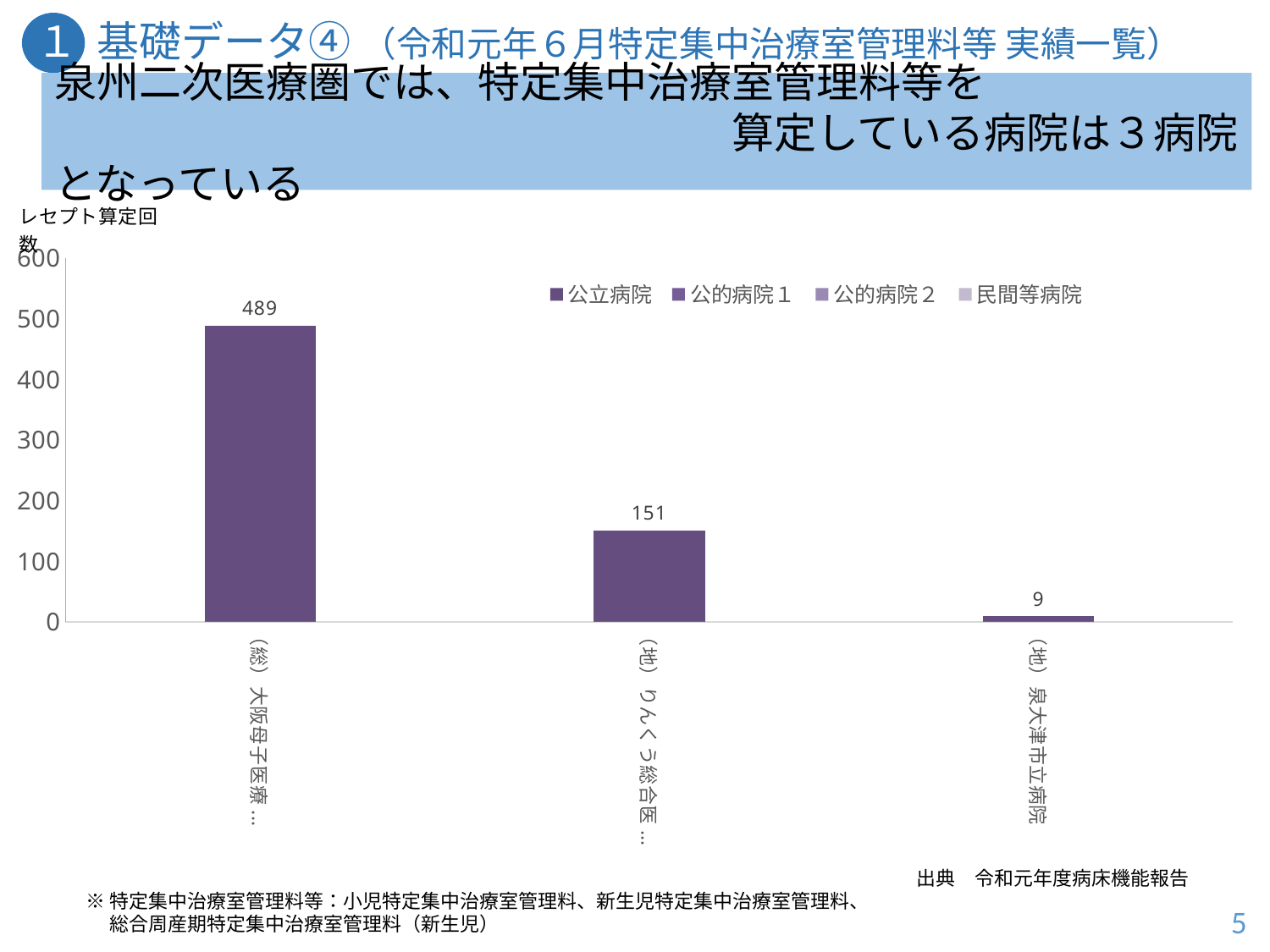
Which hospital has the highest value in the chart? (総) 大阪母子医療… Is the value for (地) りんくう総合医… greater or less than 200? less What is the difference between the values for (総) 大阪母子医療… and (地) りんくう総合医…? 338 Which hospital has the lowest value in the chart? (地) 泉大津市立病院 What is the value for (地) 泉大津市立病院? 9 Which is larger, the value for (地) りんくう総合医… or the value for (地) 泉大津市立病院? (地) りんくう総合医… What type of chart is shown on the slide? bar chart What is the value for (総) 大阪母子医療…? 489 How many bars (hospitals) are plotted in the chart? 3 What is the value for (地) りんくう総合医…? 151 How many series does the legend list? 4 What is the label of the vertical axis of the chart? レセプト算定回数